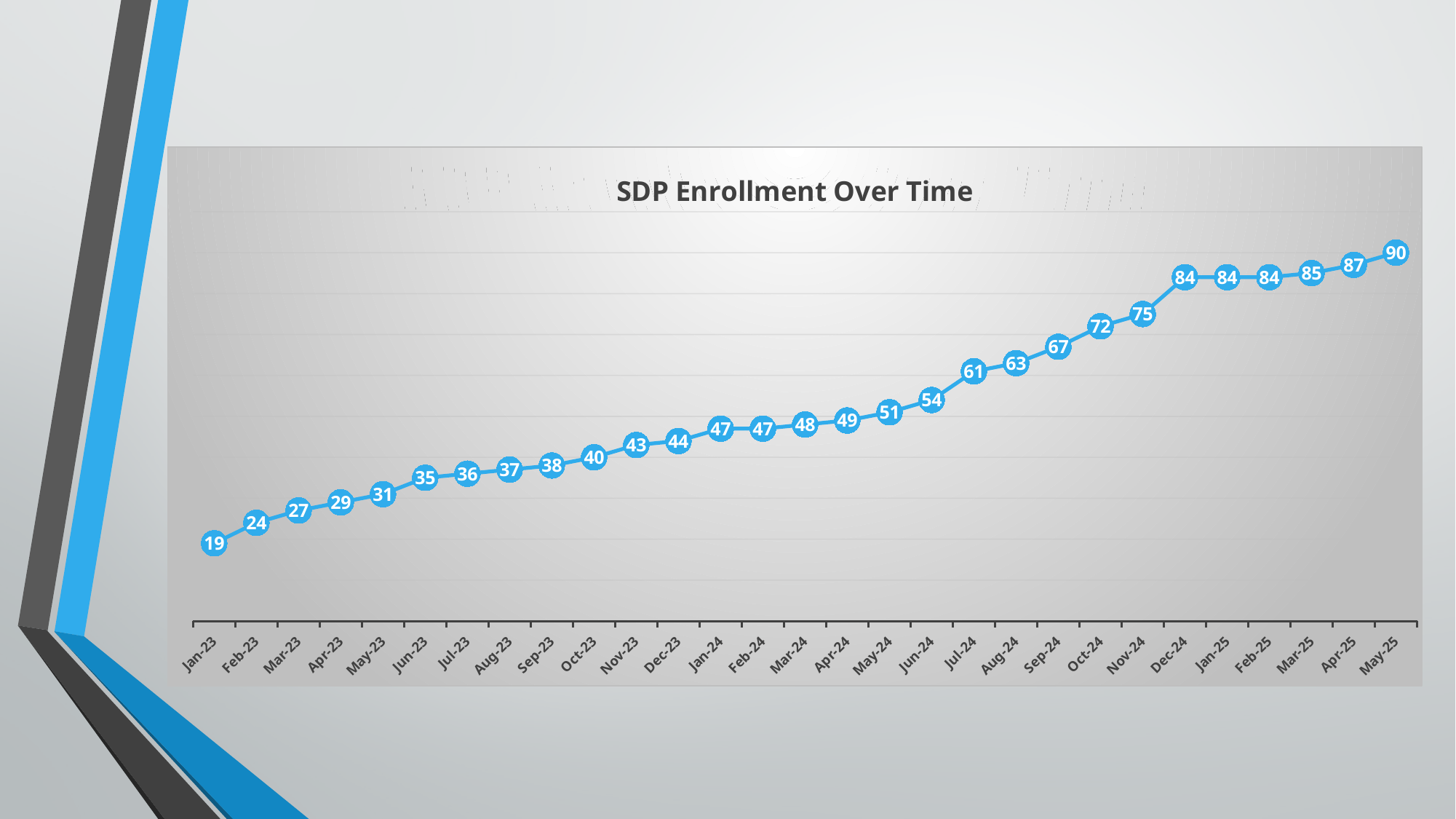
Do the enrollment values generally rise or fall from Jan-23 to May-25? rise What is the title of the chart? SDP Enrollment Over Time What is the difference between the enrollment values for Dec-24 and Nov-24? 9 What is the difference between the enrollment values for May-25 and Jan-23? 71 Which is larger, the enrollment value for Oct-24 or for Jun-24? Oct-24 Which month has the lowest enrollment value? Jan-23 Which month has the highest enrollment value? May-25 What kind of chart is shown on the slide? line chart What is the enrollment value for Jul-24? 61 What is the enrollment value for Jan-23? 19 What is the enrollment value for Dec-24? 84 How many data points are plotted on the chart? 29